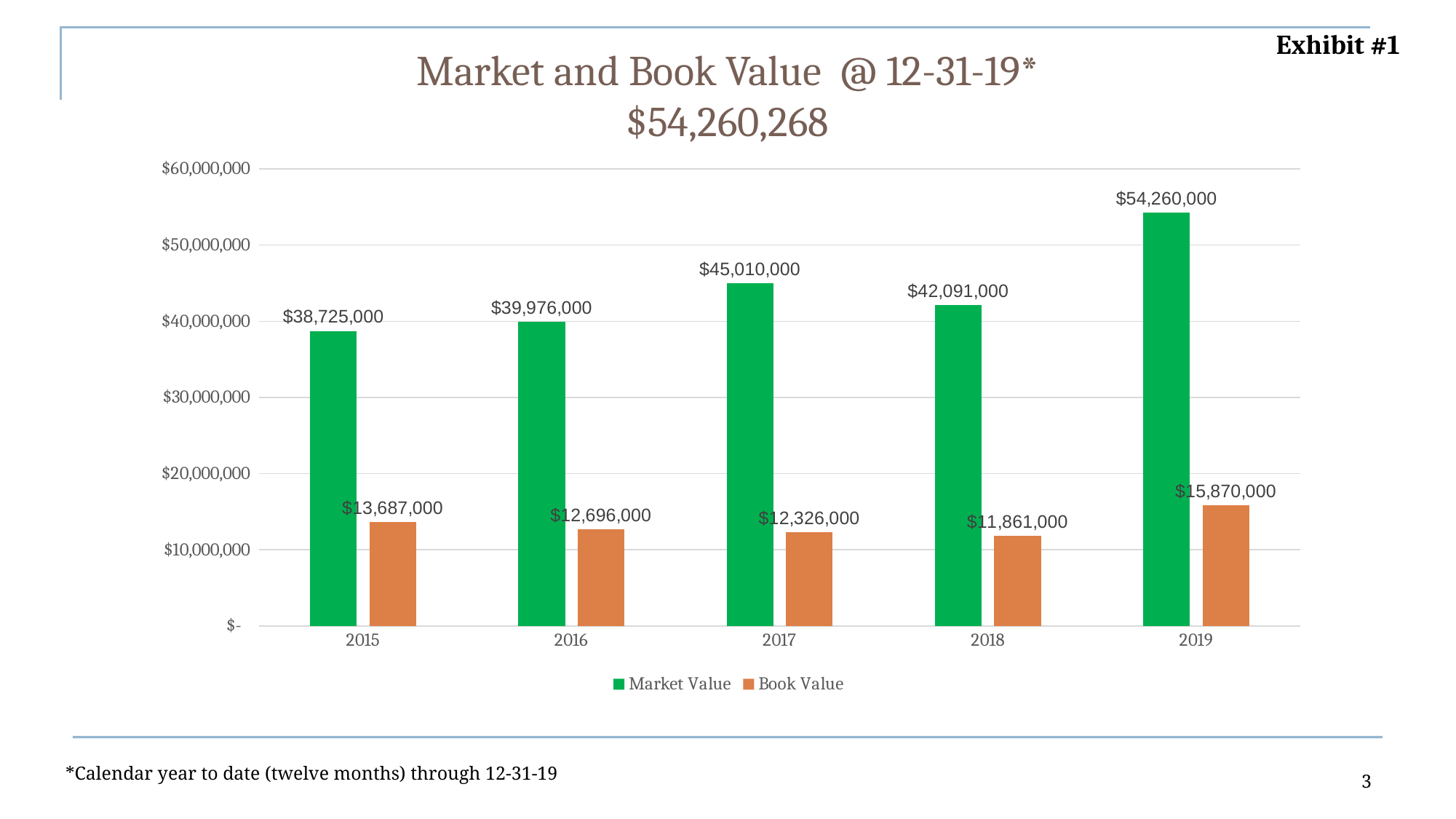
What colour are the Book Value bars? Orange How many years are shown on the x axis? 5 What is the Book Value for 2018? $11,861,000 How many series does the legend list? 2 What is the Market Value for 2017? $45,010,000 Is the Book Value for 2019 greater or less than $20,000,000? less What kind of chart is shown on the slide? Bar chart What is the Market Value for 2015? $38,725,000 What is the difference between the Market Value and the Book Value in 2019? $38,390,000 Which year has the highest Market Value? 2019 Which is larger, the Market Value in 2017 or the Market Value in 2018? Market Value in 2017 Which year has the lowest Book Value? 2018